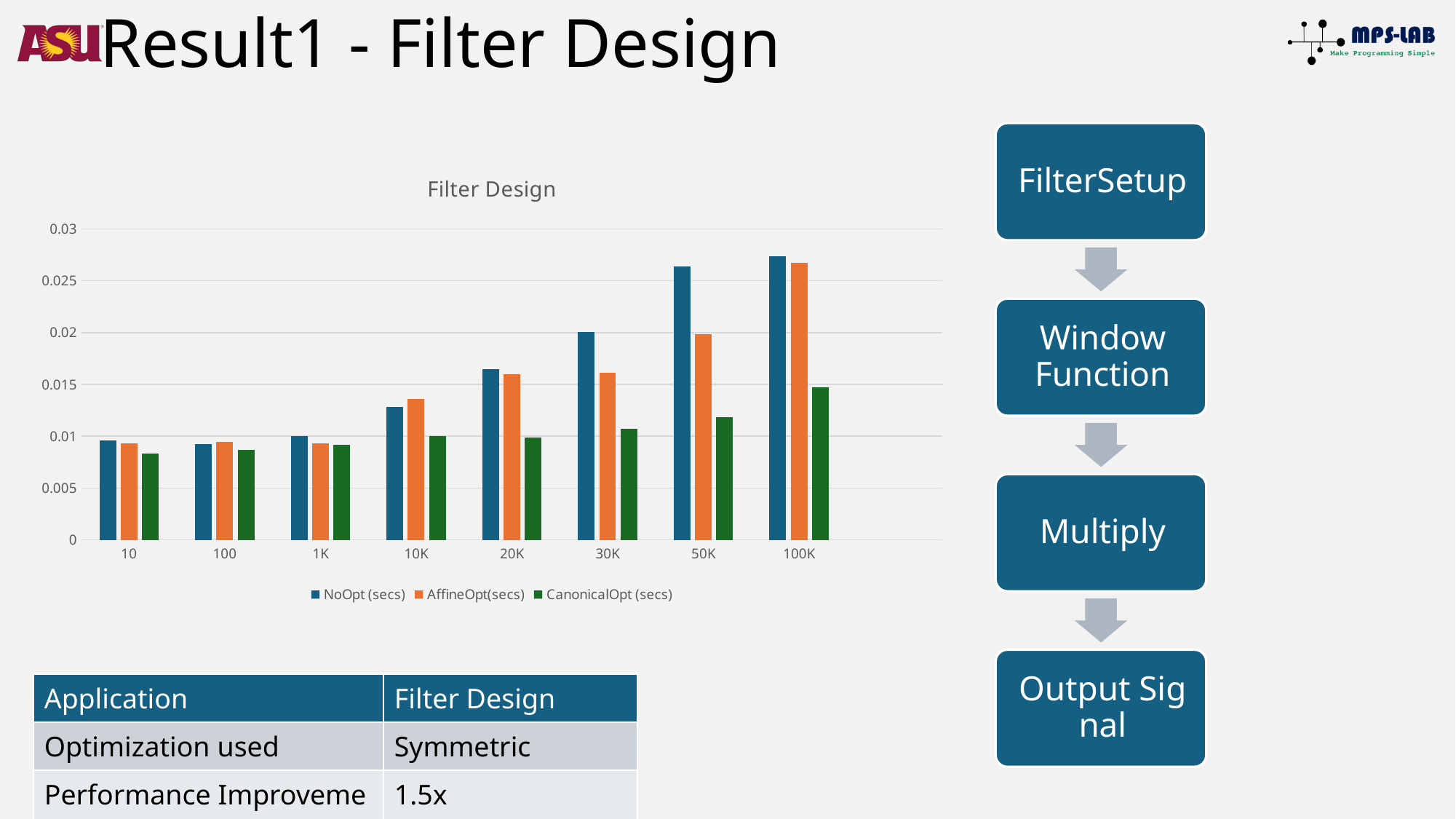
Which series has the lowest value at 50K? CanonicalOpt (secs) How many series does the chart's legend list? 3 At 30K, which is larger: NoOpt (secs) or AffineOpt(secs)? NoOpt (secs) Is the AffineOpt(secs) value at 50K greater or less than 0.015? greater Is the CanonicalOpt (secs) value at 100K greater or less than 0.02? less How many categories are shown on the x axis of the chart? 8 What is the title of the chart? Filter Design Do the NoOpt (secs) values generally rise or fall as the x axis goes from 10 to 100K? rise What type of chart is shown on the slide? bar chart Is the NoOpt (secs) value at 10K greater or less than 0.01? greater At which category does the NoOpt (secs) series reach its highest value? 100K